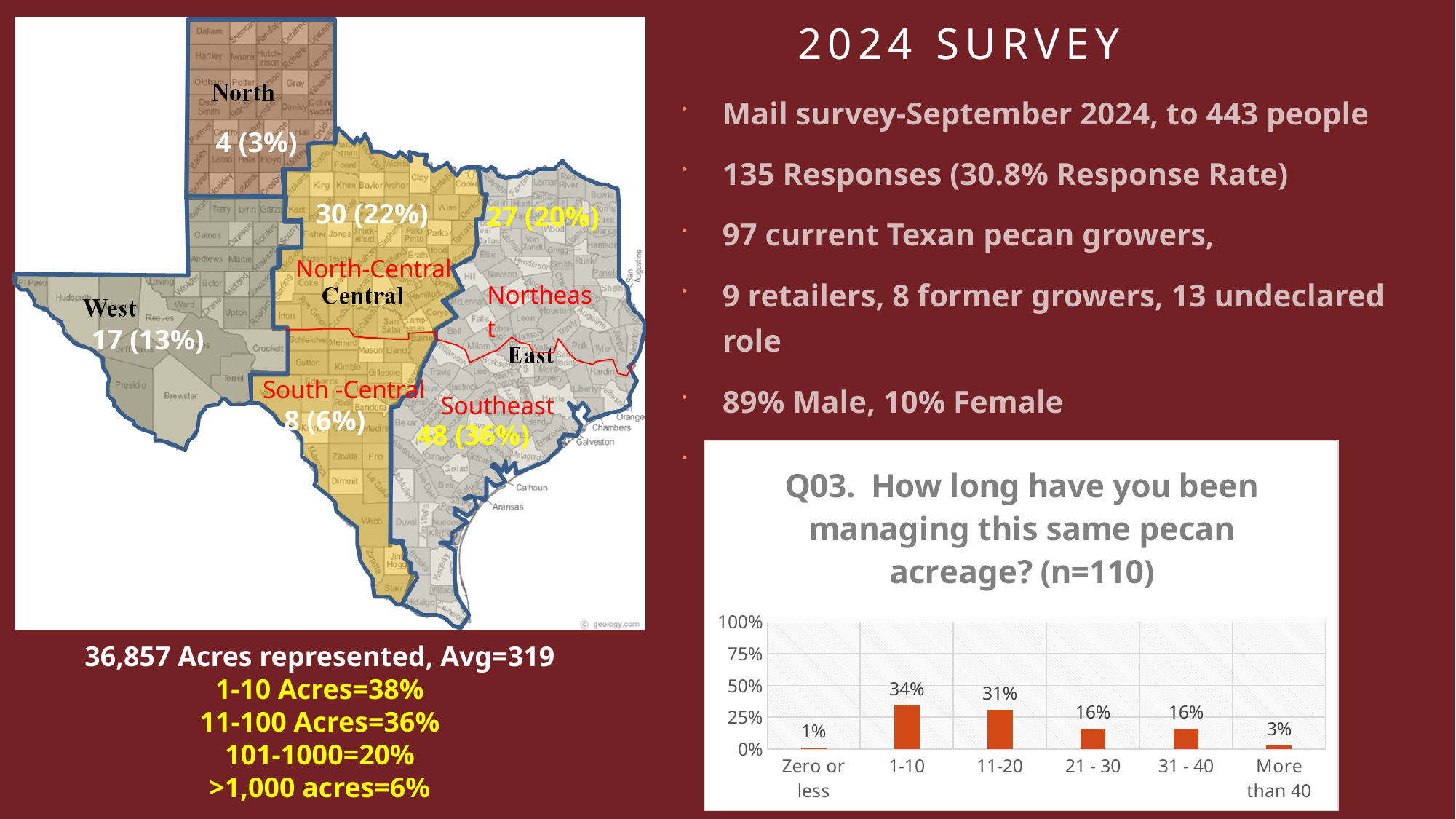
What is the value for the 'Zero or less' category? 1% What is the difference between the values for 1-10 and 11-20? 3% Which category has the highest value in the Q03 chart? 1-10 What percentage is shown for the 'More than 40' category? 3% What is the sample size (n) stated in the Q03 chart title? 110 Which is larger, the value for 21 - 30 or the value for More than 40? 21 - 30 What percentage of respondents have been managing the same pecan acreage for 1-10 years? 34% Which category has the lowest value in the Q03 chart? Zero or less What kind of chart is used for Q03? bar chart What is the value shown for the 11-20 category in the Q03 chart? 31% Is the value for 1-10 greater or less than 25%? greater How many categories are shown on the x axis of the Q03 chart? 6